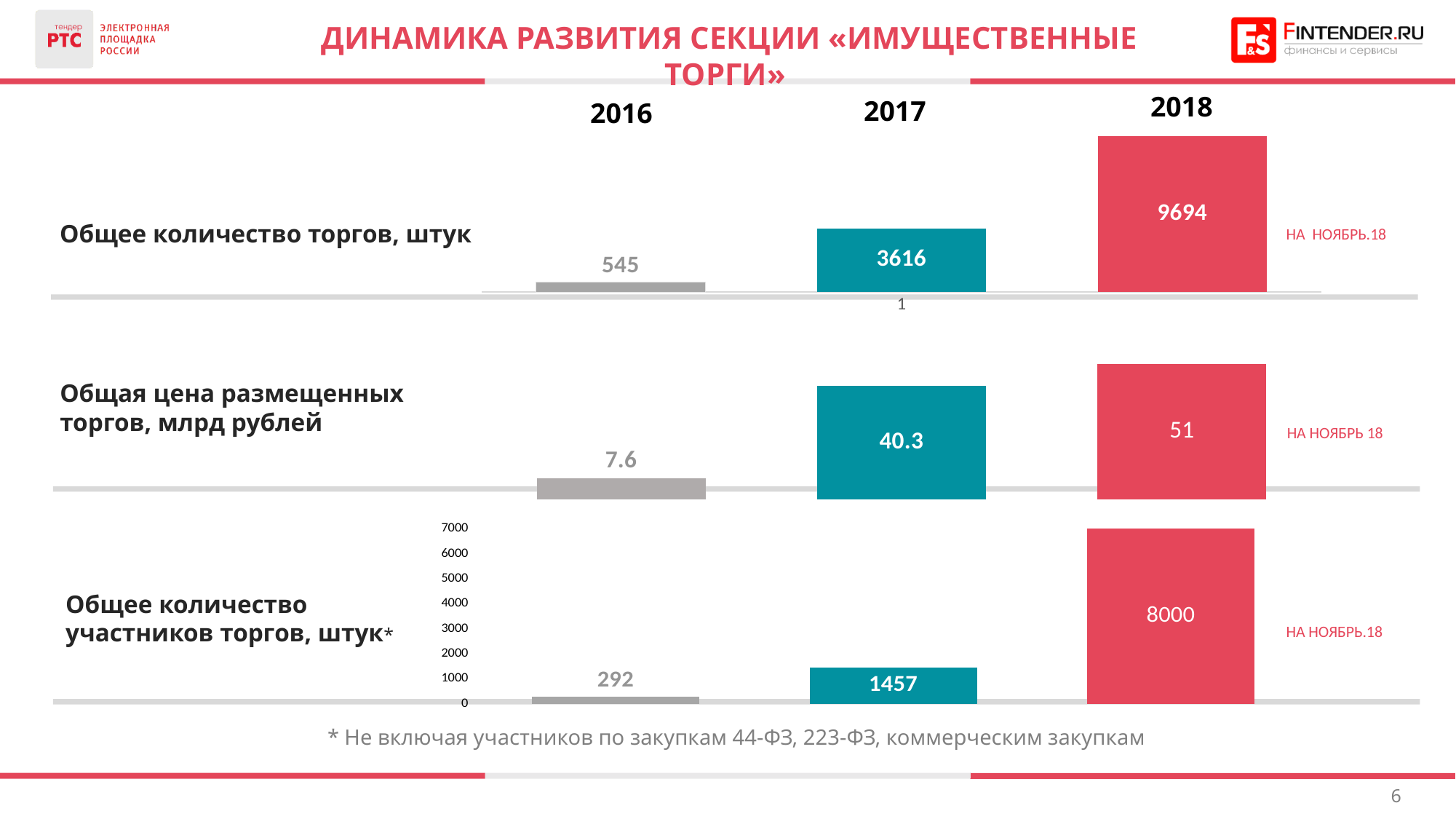
In the chart "Общее количество участников торгов, штук", is the value for 2017 larger or smaller than the value for 2016? larger How many years are shown in the chart "Общая цена размещенных торгов, млрд рублей"? 3 In the chart "Общее количество торгов, штук", what is the difference between the 2018 and 2017 values? 6078 In the chart "Общее количество торгов, штук", do the values rise or fall from 2016 to 2018? rise In the chart "Общее количество торгов, штук", what is the value for 2017? 3616 In the chart "Общее количество участников торгов, штук", which year has the highest value? 2018 In the chart "Общая цена размещенных торгов, млрд рублей", what is the value for 2018? 51 In the chart "Общая цена размещенных торгов, млрд рублей", what is the difference between the 2018 and 2017 values? 10.7 In the chart "Общее количество участников торгов, штук", what is the value for 2017? 1457 In the chart "Общее количество торгов, штук", what is the value for 2018? 9694 In the chart "Общая цена размещенных торгов, млрд рублей", what is the value for 2016? 7.6 In the chart "Общее количество торгов, штук", which year has the lowest value? 2016